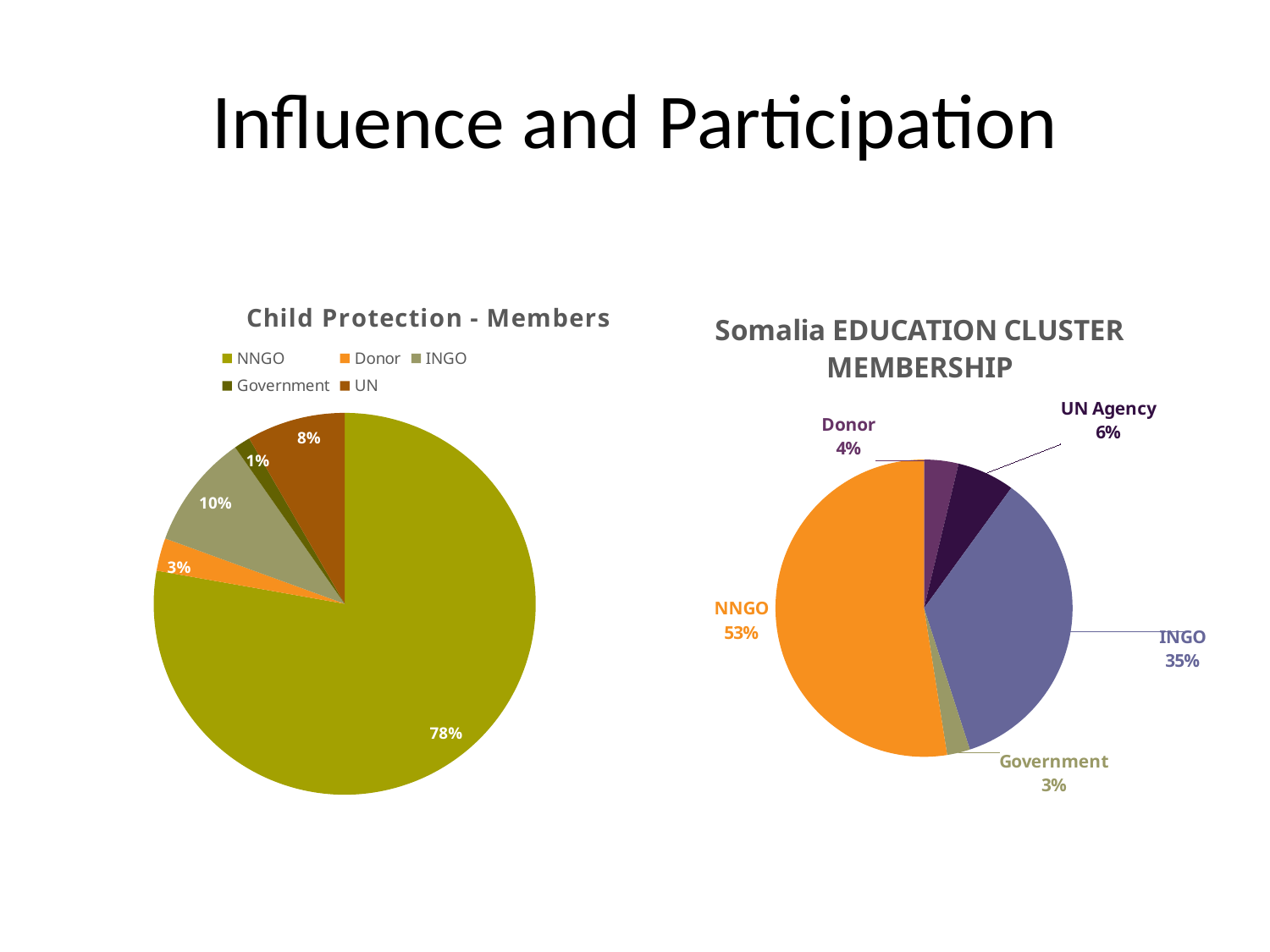
In the Child Protection - Members chart, how many categories does the legend list? 5 In the Somalia EDUCATION CLUSTER MEMBERSHIP chart, what share does UN Agency hold? 6% In the Child Protection - Members chart, which category has the smallest share? Government In the Child Protection - Members chart, what share does INGO hold? 10% What kind of chart is the Child Protection - Members chart? Pie chart In the Somalia EDUCATION CLUSTER MEMBERSHIP chart, what is the difference in percentage points between the NNGO and INGO shares? 18 In the Somalia EDUCATION CLUSTER MEMBERSHIP chart, what share does INGO hold? 35% In the Somalia EDUCATION CLUSTER MEMBERSHIP chart, which is larger, the Donor share or the Government share? Donor In the Somalia EDUCATION CLUSTER MEMBERSHIP chart, which category has the largest share? NNGO Which chart shows a larger NNGO share, Child Protection - Members or Somalia EDUCATION CLUSTER MEMBERSHIP? Child Protection - Members In the Child Protection - Members chart, what share do NNGOs hold? 78% In the Child Protection - Members chart, what is the difference in percentage points between the UN and Donor shares? 5